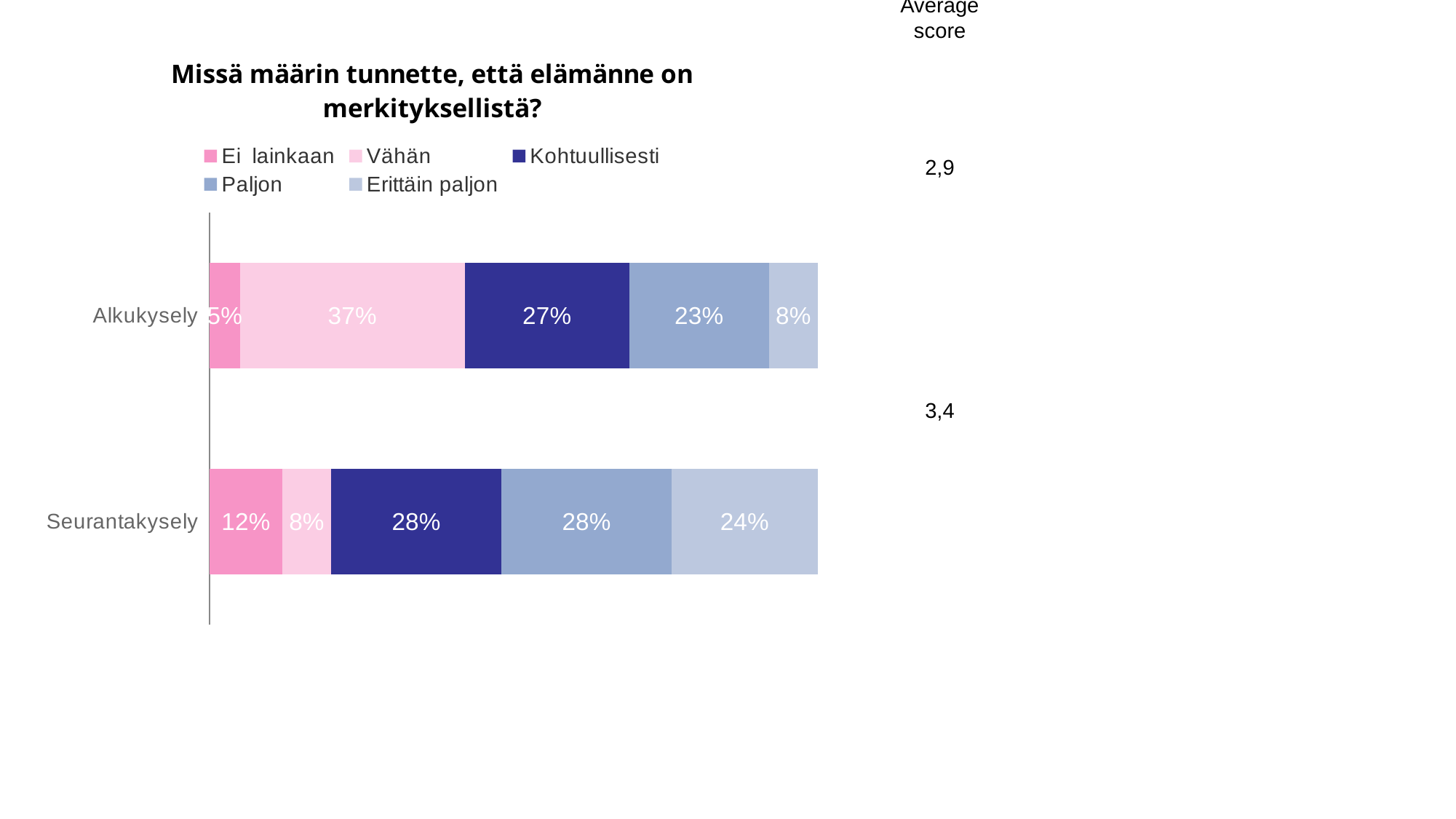
Which is larger: the Erittäin paljon value for Alkukysely or for Seurantakysely? Seurantakysely How many series does the legend list? 5 What kind of chart is shown on the slide? Stacked bar chart What is the chart's title? Missä määrin tunnette, että elämänne on merkityksellistä? Which series has the largest share in the Alkukysely bar? Vähän What is the value for Erittäin paljon in the Seurantakysely bar? 24% What is the difference between the Vähän values for Alkukysely and Seurantakysely? 29 percentage points What is the value for Vähän in the Alkukysely bar? 37% What is the value for Paljon in the Alkukysely bar? 23% Which series has the smallest share in the Alkukysely bar? Ei lainkaan How many categories (bars) are shown in the chart? 2 What is the value for Ei lainkaan in the Seurantakysely bar? 12%